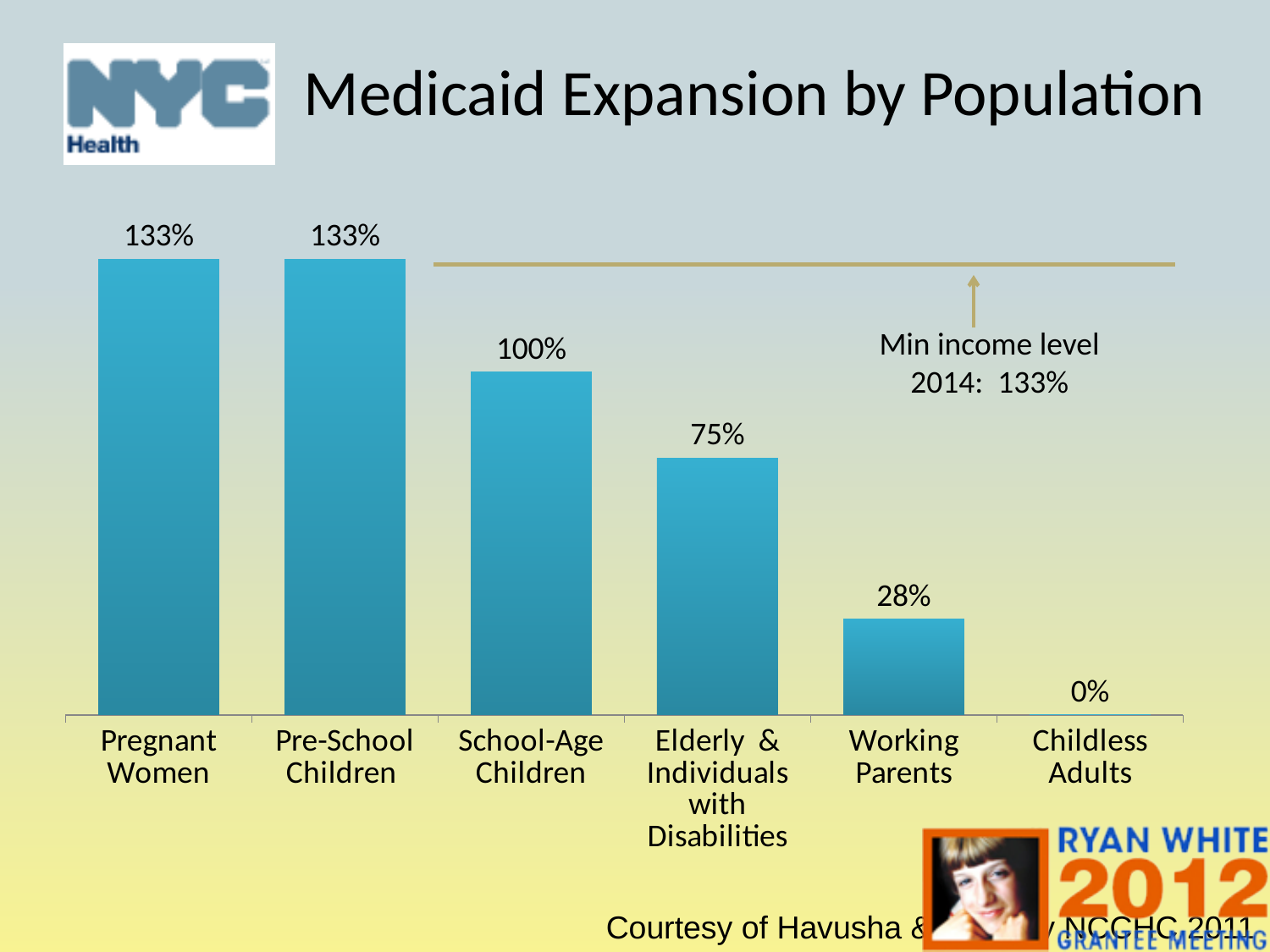
Which is larger, the value for Elderly & Individuals with Disabilities or the value for Working Parents? Elderly & Individuals with Disabilities What is the difference between the values for School-Age Children and Working Parents? 72% Do the values rise or fall from left to right across the categories? Fall What is the title of the chart? Medicaid Expansion by Population What is the value for School-Age Children? 100% What is the value for Working Parents? 28% How many categories are shown on the chart? 6 What is the value for Elderly & Individuals with Disabilities? 75% What is the value for Pregnant Women? 133% What kind of chart is shown on the slide? Bar chart What is the value for Childless Adults? 0% Which category has the lowest value? Childless Adults